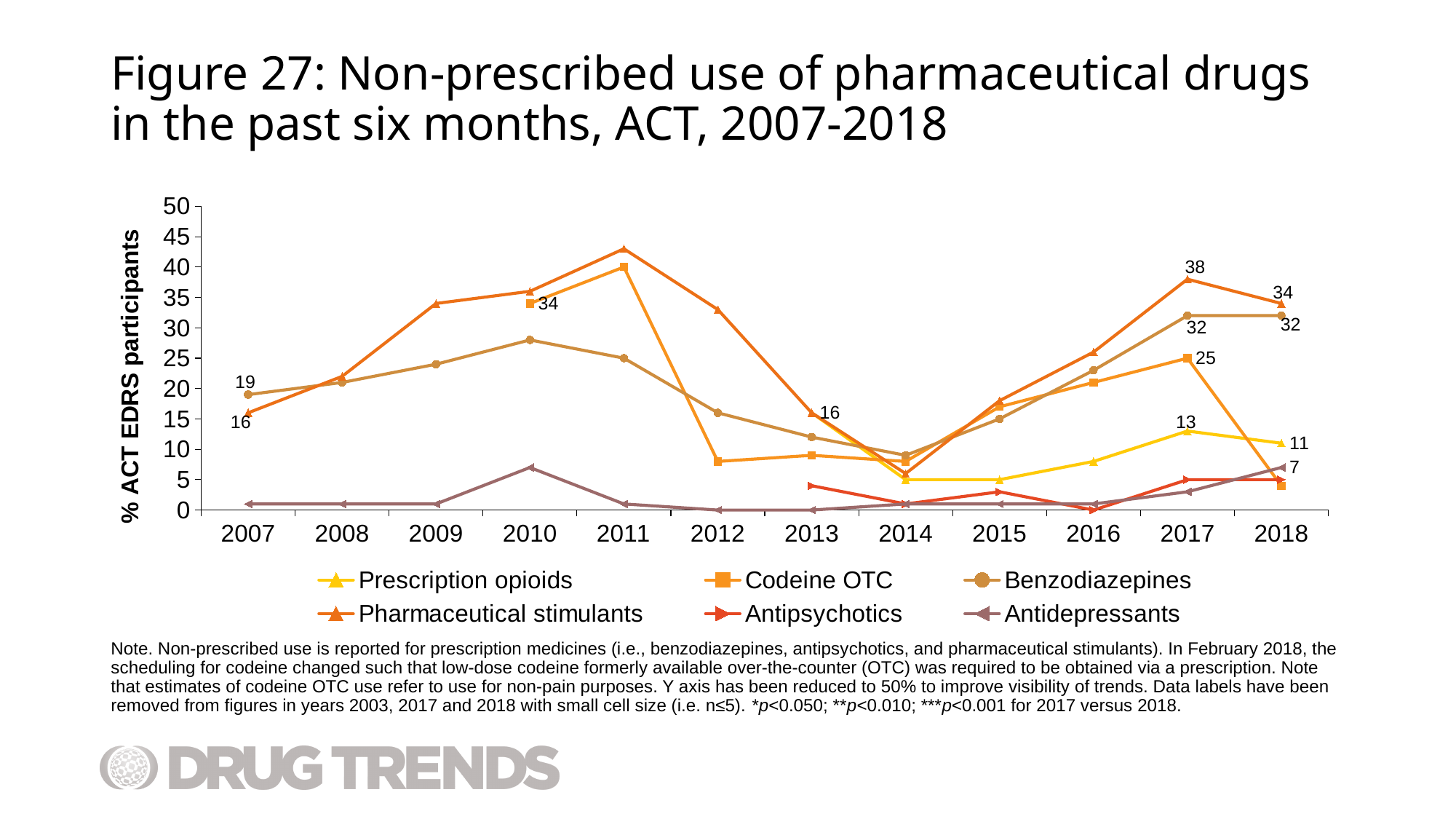
What is the label on the y axis? % ACT EDRS participants What kind of chart is shown on the slide? line chart What is the value for Benzodiazepines in 2007? 19 What is the difference between Prescription opioids in 2017 and in 2018? 2 How many years are shown on the x axis? 12 How many series does the legend list? 6 Is the value for Pharmaceutical stimulants in 2011 greater or less than 40? greater What is the value for Codeine OTC in 2010? 34 By how much did the value for Pharmaceutical stimulants change from 2017 (38) to 2018 (34)? 4 What is the value for Pharmaceutical stimulants in 2017? 38 What is the value for Pharmaceutical stimulants in 2013? 16 In 2017, which is larger: Pharmaceutical stimulants or Benzodiazepines? Pharmaceutical stimulants